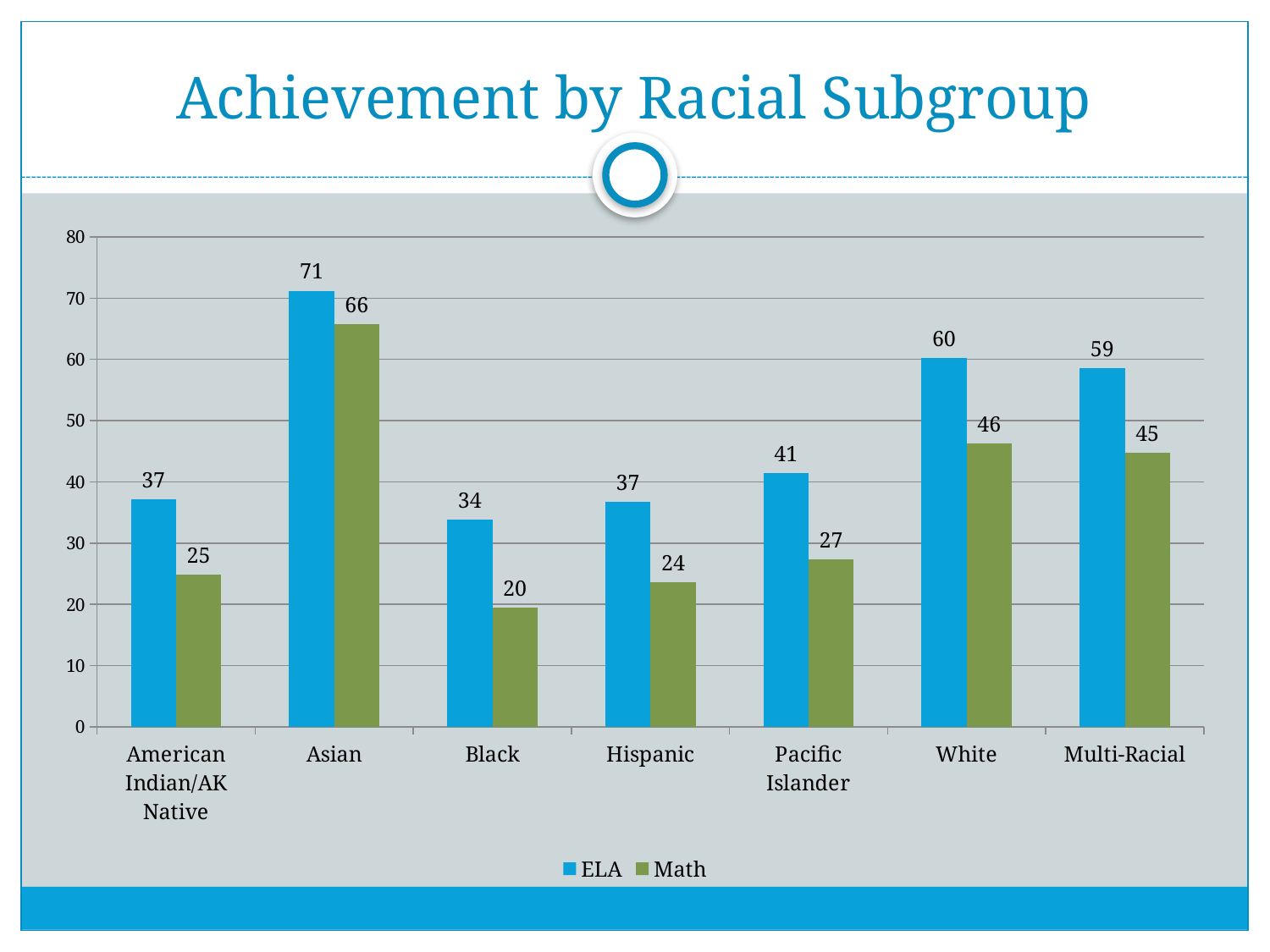
What is the title of the slide? Achievement by Racial Subgroup Is the Math value for Multi-Racial greater or less than 40? greater Which racial subgroup has the lowest Math value? Black What is the difference between the ELA and Math values for White? 14 What kind of chart is shown on the slide? bar chart How many racial subgroups are shown on the x axis? 7 What is the Math value for Pacific Islander? 27 Which racial subgroup has the highest ELA value? Asian What is the ELA value for Asian? 71 Which is larger, the ELA value for Pacific Islander or the ELA value for Hispanic? Pacific Islander What is the Math value for Black? 20 How many series does the legend list? 2